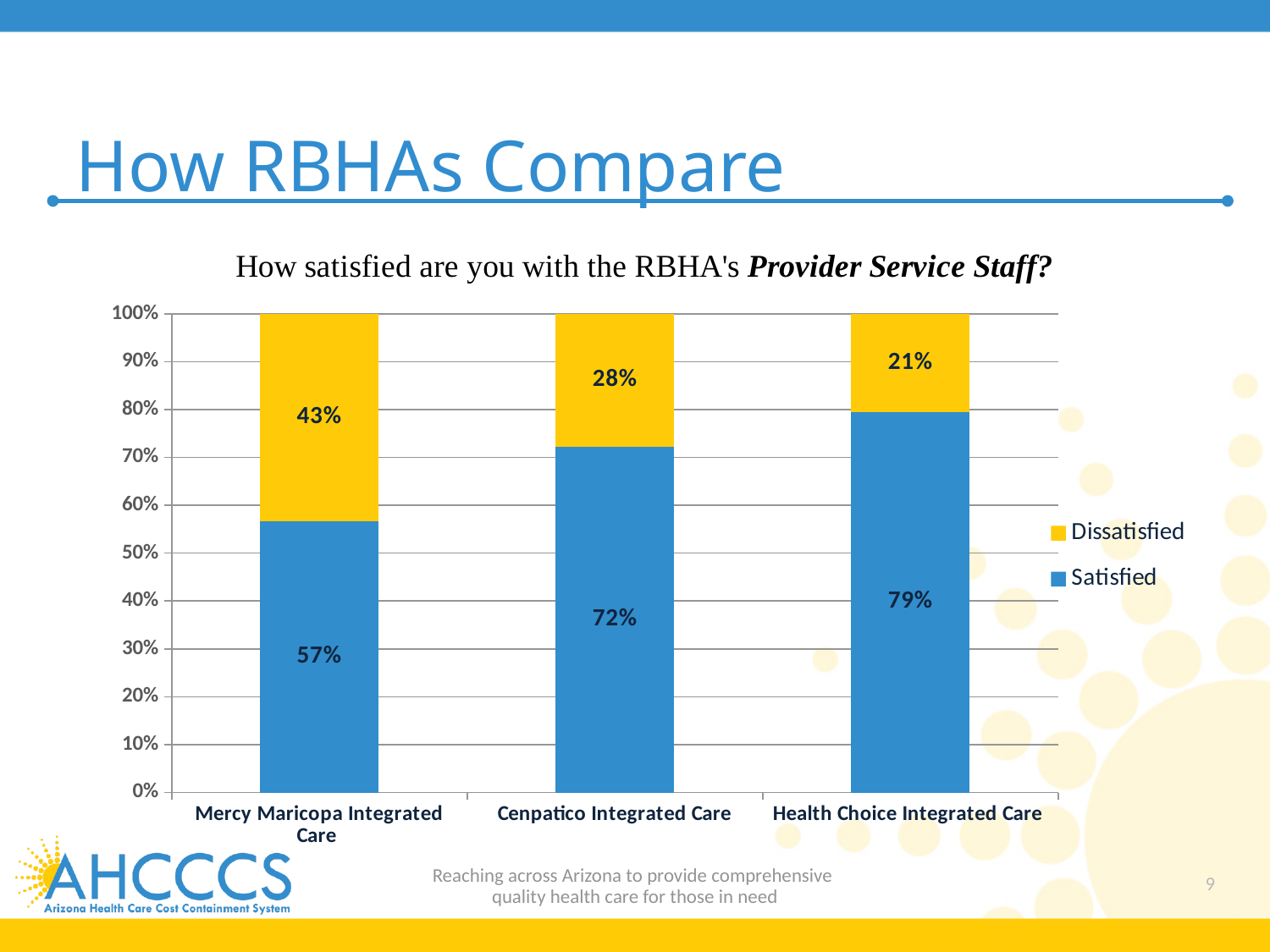
What percentage of respondents were satisfied with Mercy Maricopa Integrated Care's Provider Service Staff? 57% What is the difference between the Satisfied values for Health Choice Integrated Care and Mercy Maricopa Integrated Care? 22% Which RBHA has the lowest Dissatisfied percentage? Health Choice Integrated Care How many RBHAs are shown on the x axis of the chart? 3 Which is larger: the Dissatisfied value for Mercy Maricopa Integrated Care or for Cenpatico Integrated Care? Mercy Maricopa Integrated Care What is the Dissatisfied value for Mercy Maricopa Integrated Care? 43% Which colour represents the Dissatisfied series in the chart? Yellow What is the Satisfied value for Health Choice Integrated Care? 79% What is the Dissatisfied value for Cenpatico Integrated Care? 28% How many series does the chart legend list? 2 Which RBHA has the highest Satisfied percentage? Health Choice Integrated Care What kind of chart is shown on the slide? Stacked bar chart